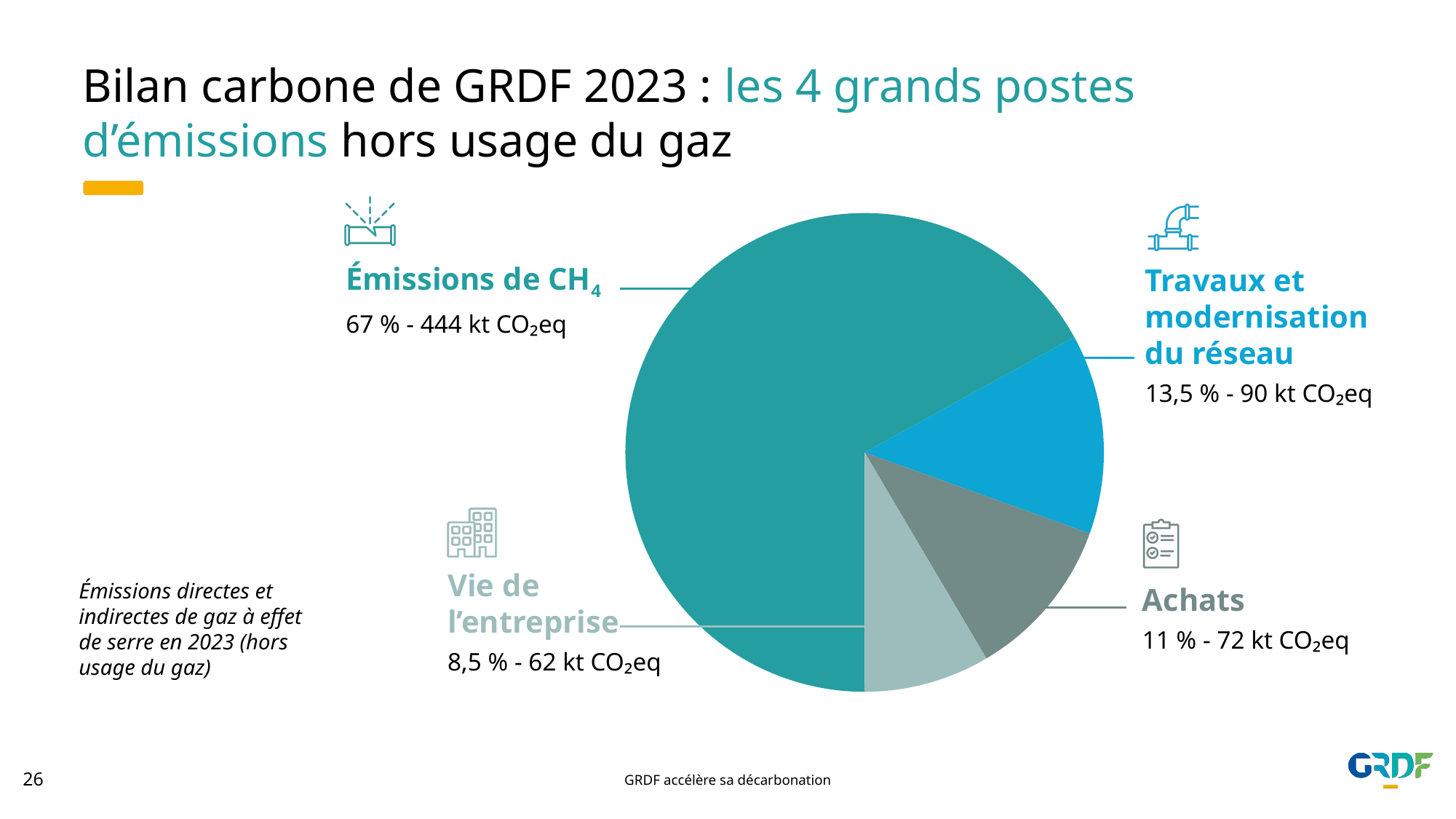
Which is larger, the value for Achats or the value for Vie de l'entreprise? Achats Which category has the largest slice of the pie? Émissions de CH4 What is the value in kt CO₂eq for Achats? 72 kt CO₂eq What is the value in kt CO₂eq for Émissions de CH4? 444 kt CO₂eq What type of chart is shown on the slide? Pie chart What share of the pie does Travaux et modernisation du réseau represent? 13,5 % How many slices does the pie chart have? 4 What is the value in kt CO₂eq for Vie de l'entreprise? 62 kt CO₂eq What share of the pie does Émissions de CH4 represent? 67 % What is the difference in kt CO₂eq between Travaux et modernisation du réseau and Achats? 18 kt CO₂eq Which category has the smallest slice of the pie? Vie de l'entreprise What colour is the slice for Travaux et modernisation du réseau? Blue